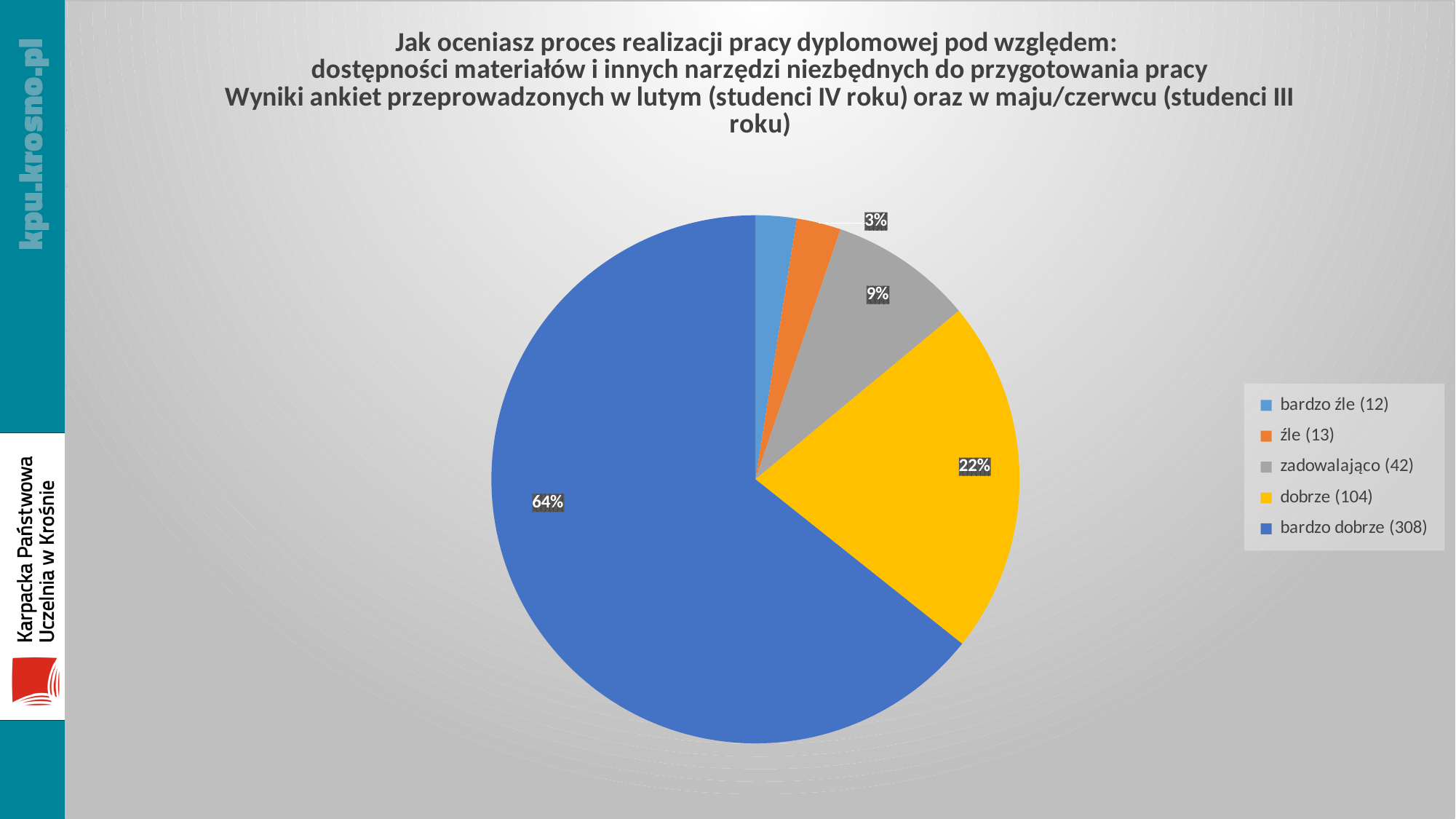
How many responses does the legend show for 'bardzo dobrze'? 308 What percentage is shown for the 'dobrze' slice? 22% What colour is the 'bardzo dobrze' slice? blue Which has more responses, 'zadowalająco' or 'źle'? zadowalająco What percentage is shown for the 'zadowalająco' slice? 9% Which category has the smallest count according to the legend? bardzo źle What percentage is shown for the 'bardzo dobrze' slice? 64% What is the difference between the counts for 'bardzo dobrze' and 'dobrze' shown in the legend? 204 How many responses does the legend show for 'dobrze'? 104 What type of chart is shown on the slide? pie chart How many categories does the pie chart have? 5 Which category has the largest slice of the pie? bardzo dobrze